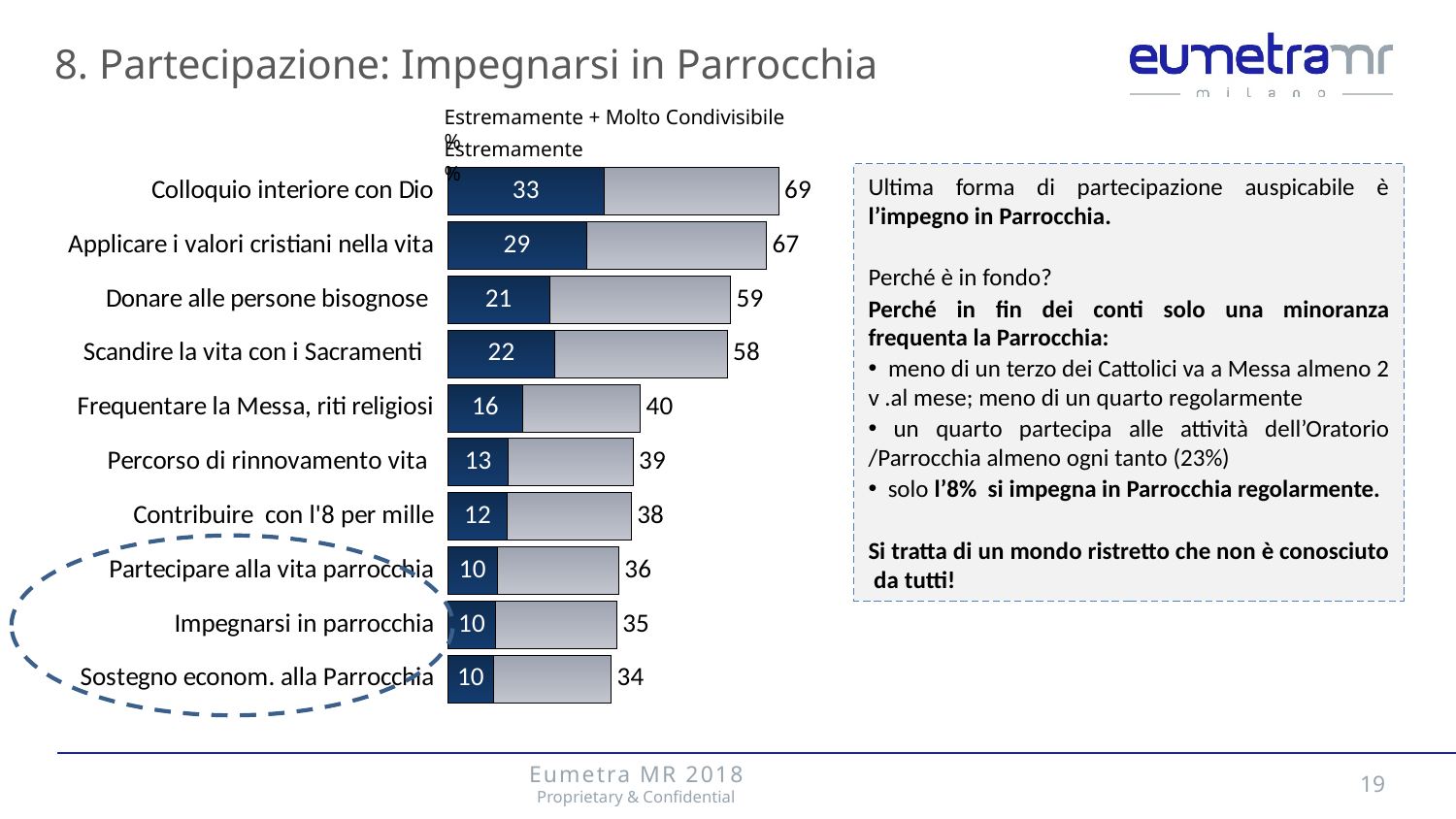
What is the 'Estremamente + Molto Condivisibile' value for 'Colloquio interiore con Dio'? 69 How many categories are shown in the chart? 10 What is the 'Estremamente' value for 'Contribuire con l'8 per mille'? 12 What is the 'Estremamente' value for 'Scandire la vita con i Sacramenti'? 22 What is the 'Estremamente + Molto Condivisibile' value for 'Impegnarsi in parrocchia'? 35 How many series does the chart show? 2 What is the difference between the 'Estremamente + Molto Condivisibile' values for 'Colloquio interiore con Dio' and 'Frequentare la Messa, riti religiosi'? 29 What kind of chart is shown on the slide? Bar chart Which category has the lowest 'Estremamente + Molto Condivisibile' value? Sostegno econom. alla Parrocchia Which has a larger 'Estremamente' value: 'Donare alle persone bisognose' or 'Scandire la vita con i Sacramenti'? Scandire la vita con i Sacramenti Which category has the highest 'Estremamente + Molto Condivisibile' value? Colloquio interiore con Dio